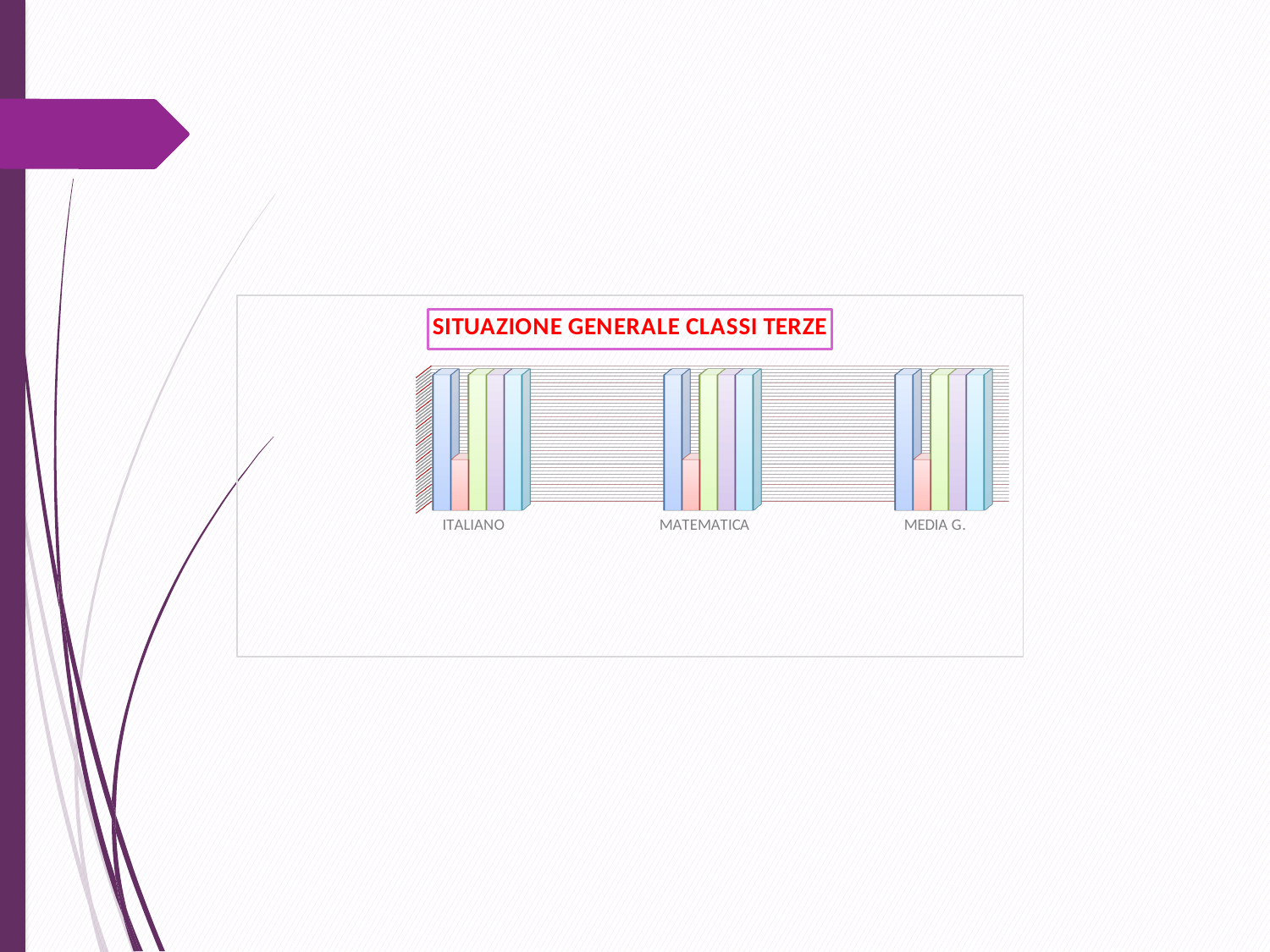
In the ITALIANO category, is the first (blue) bar taller or shorter than the second (pink) bar? Taller Which category is labelled on the far right of the chart's x axis? MEDIA G. In the MATEMATICA category, which bar is the shortest? The second (pink) bar How many categories are shown on the x axis of the chart? 3 In the MEDIA G. category, which bar is the shortest? The second (pink) bar In the ITALIANO category, which bar is the shortest? The second (pink) bar How many bars are plotted for each category in the chart? 5 What kind of chart is shown on the slide? Bar chart What is the title of the chart? SITUAZIONE GENERALE CLASSI TERZE In the MEDIA G. category, is the fifth (light blue) bar taller or shorter than the second (pink) bar? Taller In the MATEMATICA category, is the third (green) bar taller or shorter than the second (pink) bar? Taller